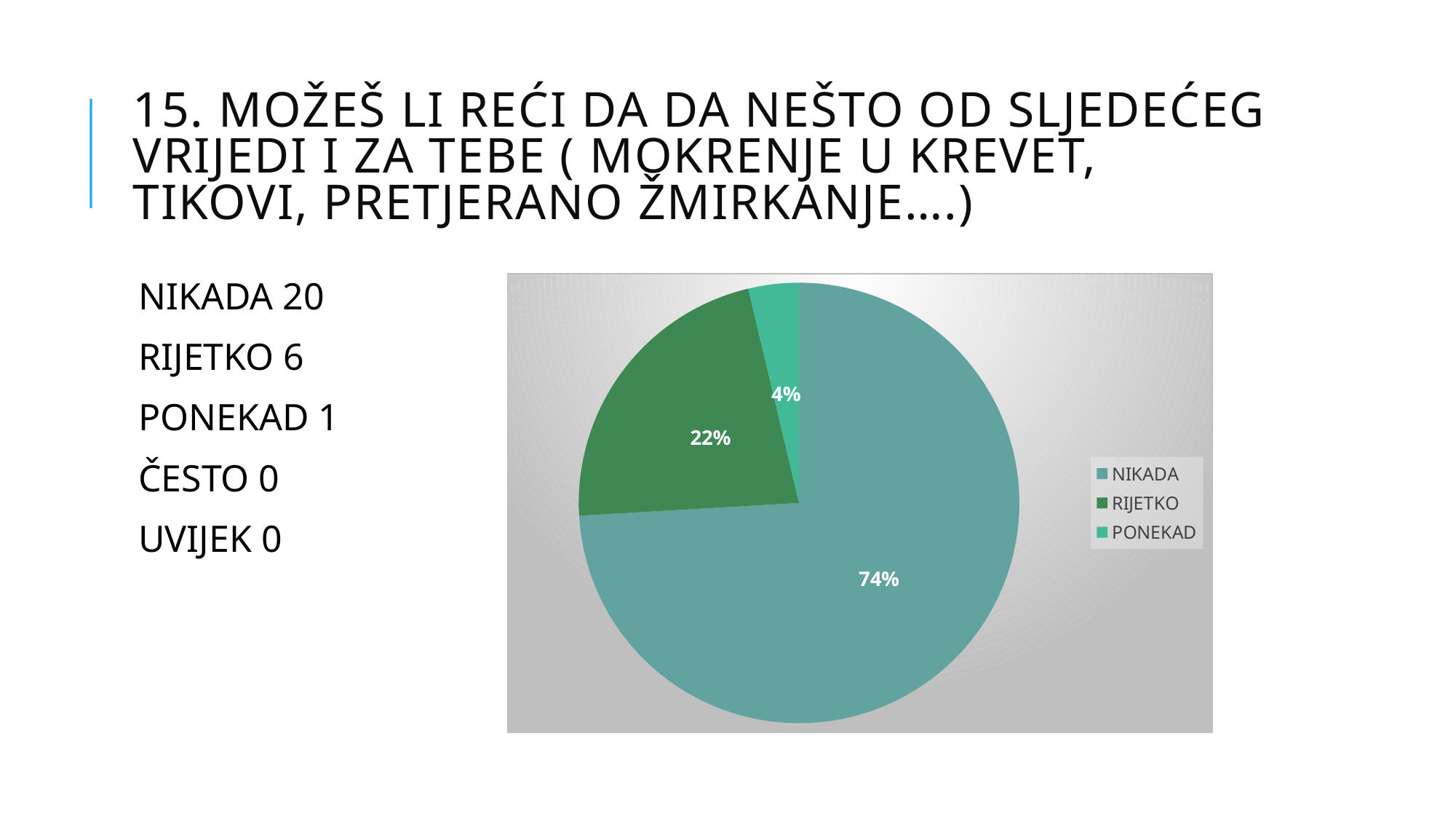
What percentage of the pie chart does the PONEKAD slice represent? 4% What is the difference in percentage points between the NIKADA slice and the RIJETKO slice? 52 How many slices does the pie chart have? 3 What percentage of the pie chart does the RIJETKO slice represent? 22% Which legend entry is shown in the darkest green colour? RIJETKO Which slice is larger, RIJETKO or PONEKAD? RIJETKO How many entries does the legend list? 3 Which category has the largest slice in the pie chart? NIKADA What percentage of the pie chart does the NIKADA slice represent? 74% What kind of chart is shown on the slide? Pie chart What is the combined share of the RIJETKO and PONEKAD slices? 26% Which category has the smallest slice in the pie chart? PONEKAD